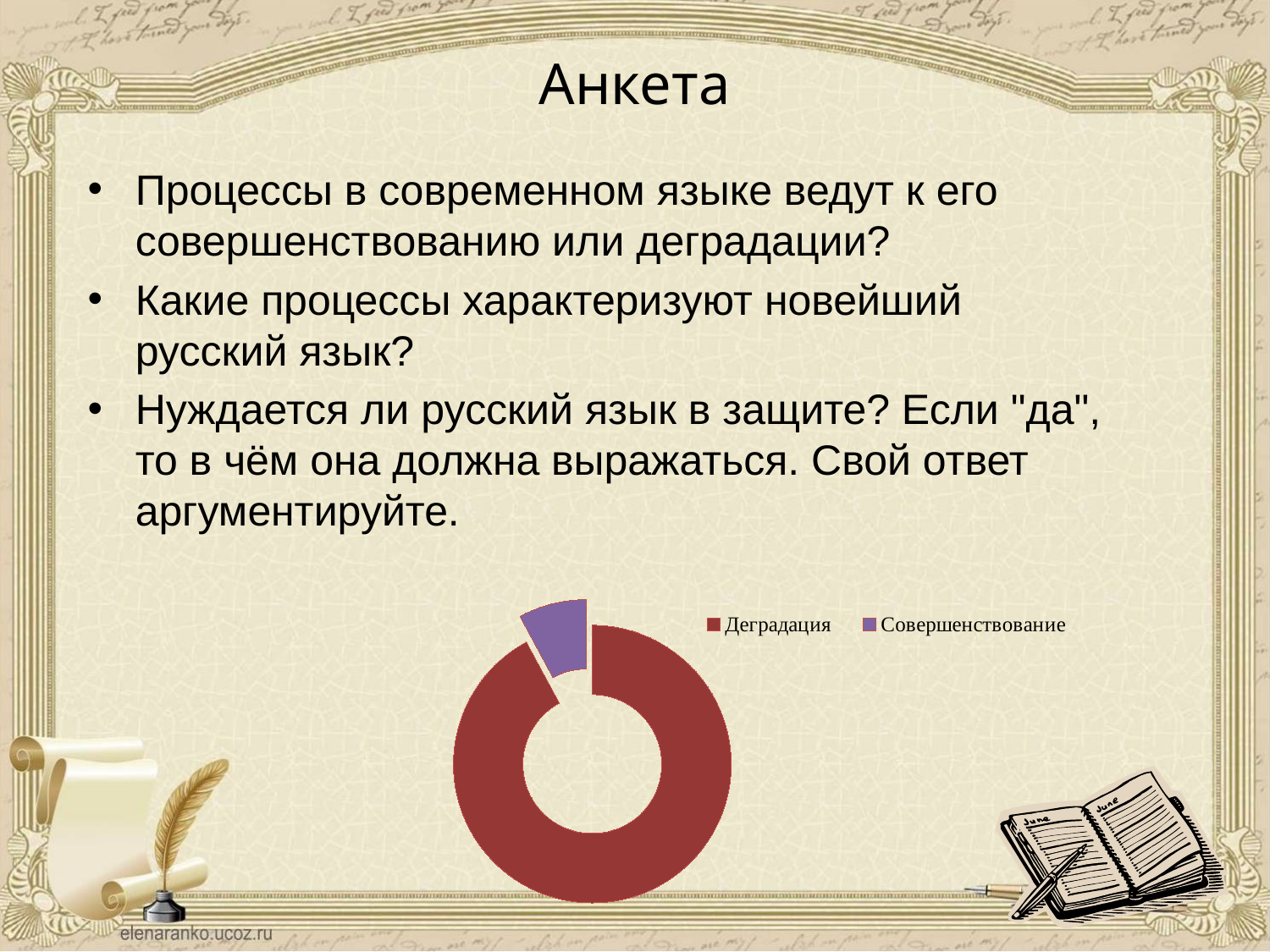
What kind of chart is shown on the slide? Doughnut chart Which slice is larger, Деградация or Совершенствование? Деградация What colour is the Деградация slice in the chart? Dark red Which category has the largest slice in the doughnut chart? Деградация How many entries does the chart legend list? 2 Which category has the smallest slice in the doughnut chart? Совершенствование How many slices does the doughnut chart have? 2 What colour is the Совершенствование slice in the chart? Purple